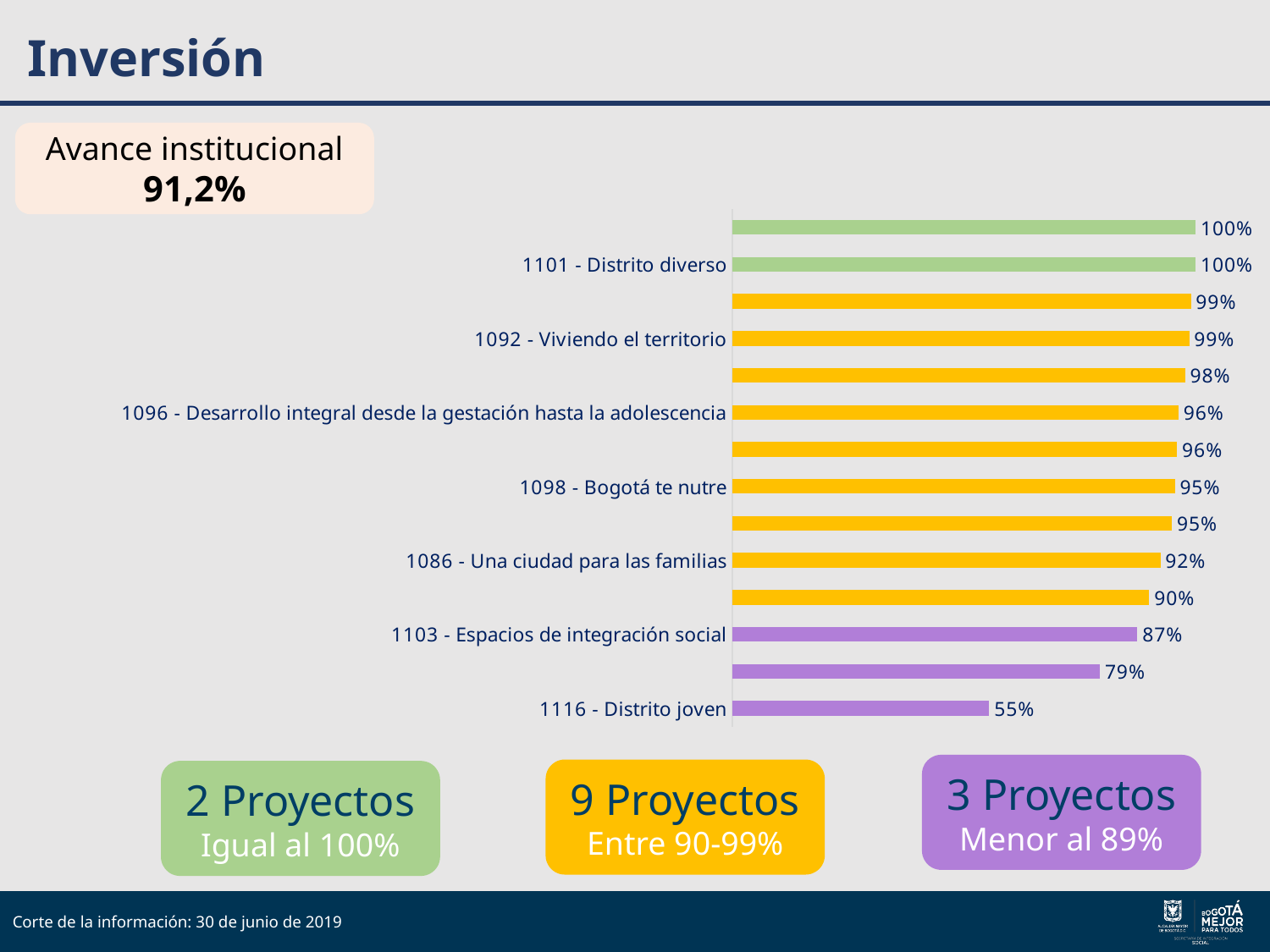
What is the value shown for 1116 - Distrito joven? 55% What colour is the bar for 1116 - Distrito joven? Purple What is the difference between the values for 1101 - Distrito diverso and 1116 - Distrito joven? 45 percentage points What kind of chart is shown on the slide? Bar chart What is the value shown for 1101 - Distrito diverso? 100% What is the value shown for 1096 - Desarrollo integral desde la gestación hasta la adolescencia? 96% What is the value shown for 1103 - Espacios de integración social? 87% How many bars are plotted in the chart? 14 What is the value shown for 1092 - Viviendo el territorio? 99% What is the value shown for 1098 - Bogotá te nutre? 95% Which has a higher value, 1098 - Bogotá te nutre or 1086 - Una ciudad para las familias? 1098 - Bogotá te nutre Which labeled project has the lowest value in the chart? 1116 - Distrito joven